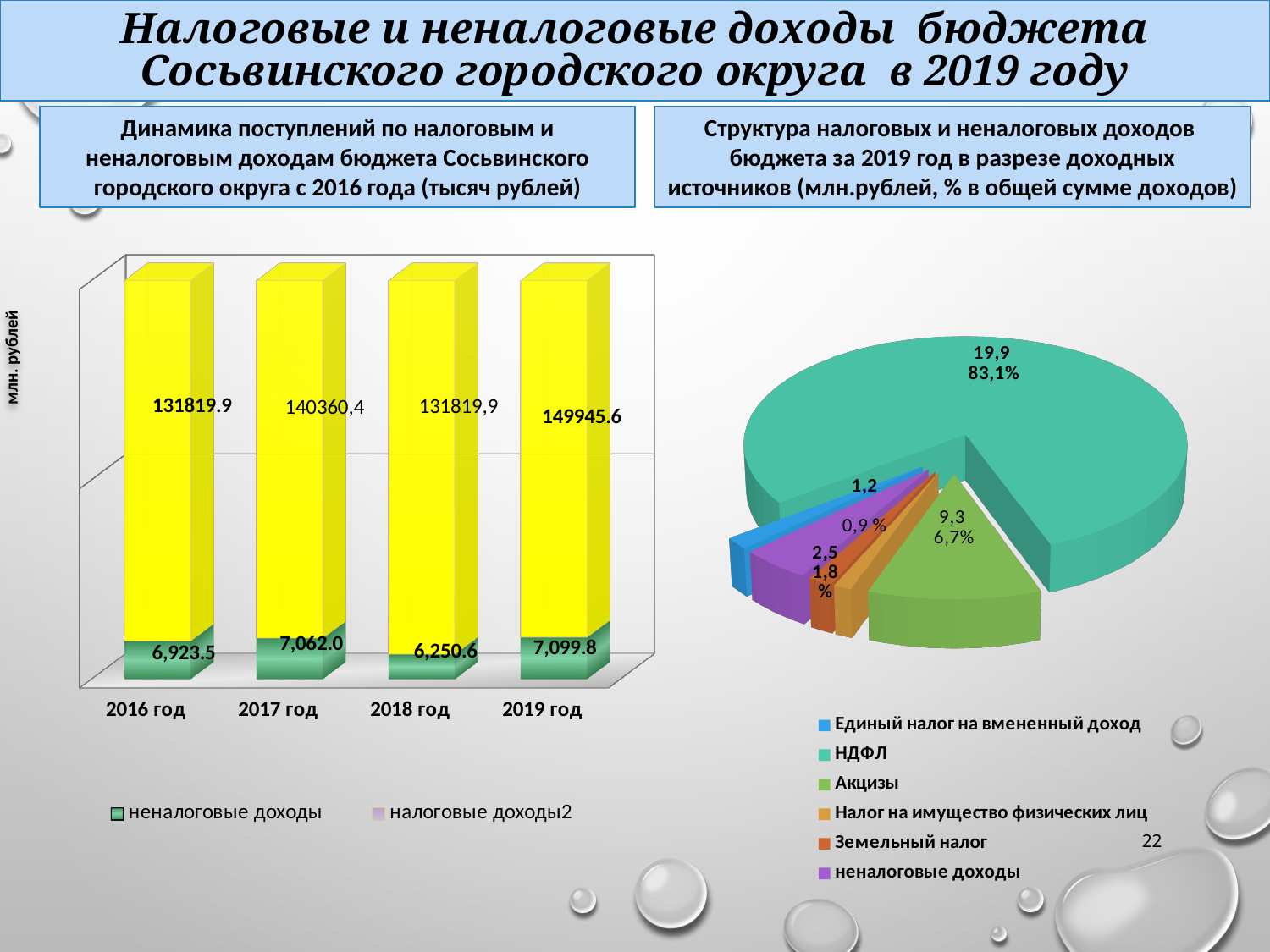
How many entries does the legend of the right pie chart list? 6 In the left bar chart, which year has the lowest value of неналоговые доходы? 2018 год In the left bar chart, what is the value of налоговые доходы2 for 2019 год? 149945.6 In the left bar chart, which year has the highest value of неналоговые доходы? 2019 год In the left bar chart, what is the value of неналоговые доходы for 2016 год? 6,923.5 How many series does the legend of the left bar chart list? 2 In the right pie chart, what share of total income does НДФЛ account for? 83,1% What kind of chart is the left chart, 'Динамика поступлений по налоговым и неналоговым доходам'? bar chart How many years are shown on the x axis of the left bar chart? 4 What kind of chart is the right chart, 'Структура налоговых и неналоговых доходов бюджета за 2019 год'? pie chart In the left bar chart, what is the value of неналоговые доходы for 2018 год? 6,250.6 In the left bar chart, what is the difference between неналоговые доходы in 2019 год and 2016 год? 176.3